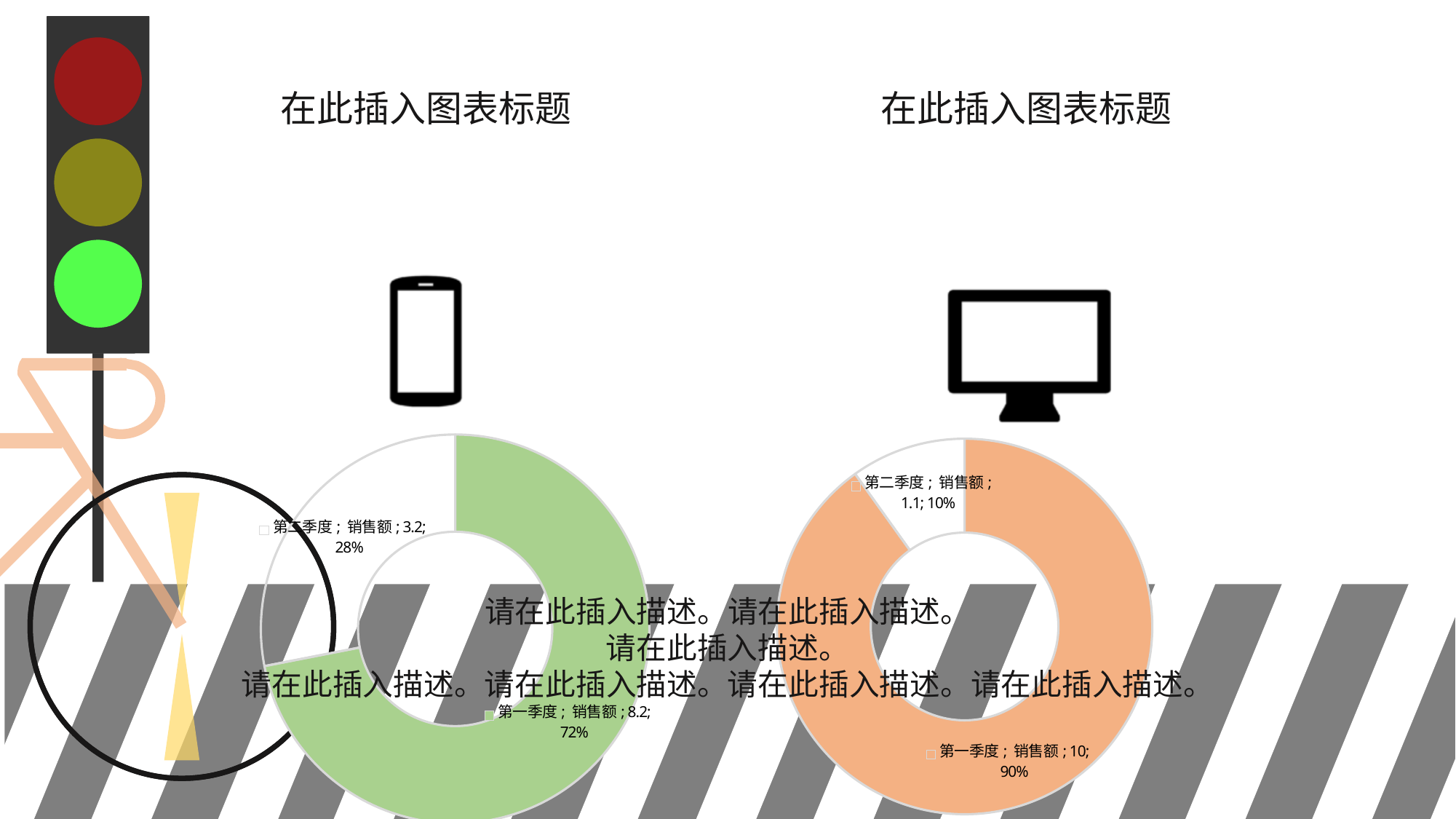
In the right chart, what share of the doughnut does 第二季度 take? 10% In the left chart, what share of the doughnut does 第一季度 take? 72% In the right chart, what is the 销售额 value for 第一季度? 10 In the right chart, what is the difference in 销售额 between 第一季度 and 第二季度? 8.9 In the left chart, what is the difference in 销售额 between 第一季度 and 第二季度? 5 In the right chart, which quarter has the larger 销售额? 第一季度 What type of chart is the right chart? Doughnut chart In the left chart, what is the 销售额 value for 第二季度? 3.2 How many slices does the left chart have? 2 In the right chart, what is the 销售额 value for 第二季度? 1.1 In the left chart, what is the 销售额 value for 第一季度? 8.2 In the left chart, what share of the doughnut does 第二季度 take? 28%